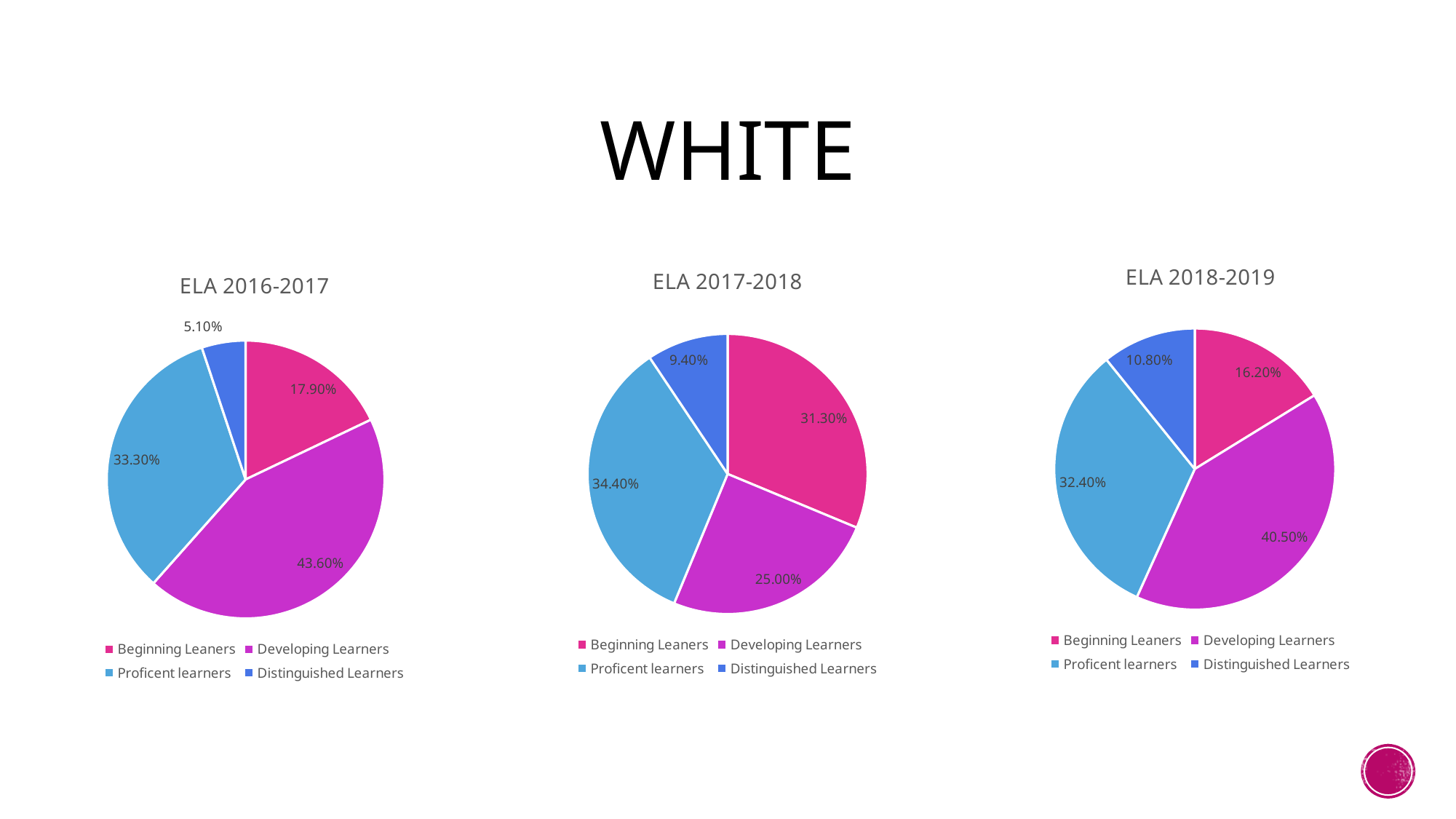
In the ELA 2017-2018 chart, which category has the largest slice? Proficent learners What is the title of the slide? WHITE In the ELA 2018-2019 chart, which is larger, Beginning Leaners or Distinguished Learners? Beginning Leaners In the ELA 2016-2017 chart, what is the value for Developing Learners? 43.60% How many slices does the ELA 2016-2017 chart have? 4 How many series does the legend of the ELA 2017-2018 chart list? 4 In the ELA 2017-2018 chart, what is the difference between Beginning Leaners and Developing Learners? 6.30% In the ELA 2018-2019 chart, which category has the largest slice? Developing Learners In the ELA 2016-2017 chart, which category has the smallest slice? Distinguished Learners What kind of chart is the ELA 2018-2019 chart? Pie chart In the ELA 2018-2019 chart, what is the value for Proficent learners? 32.40% In the ELA 2017-2018 chart, what is the value for Distinguished Learners? 9.40%